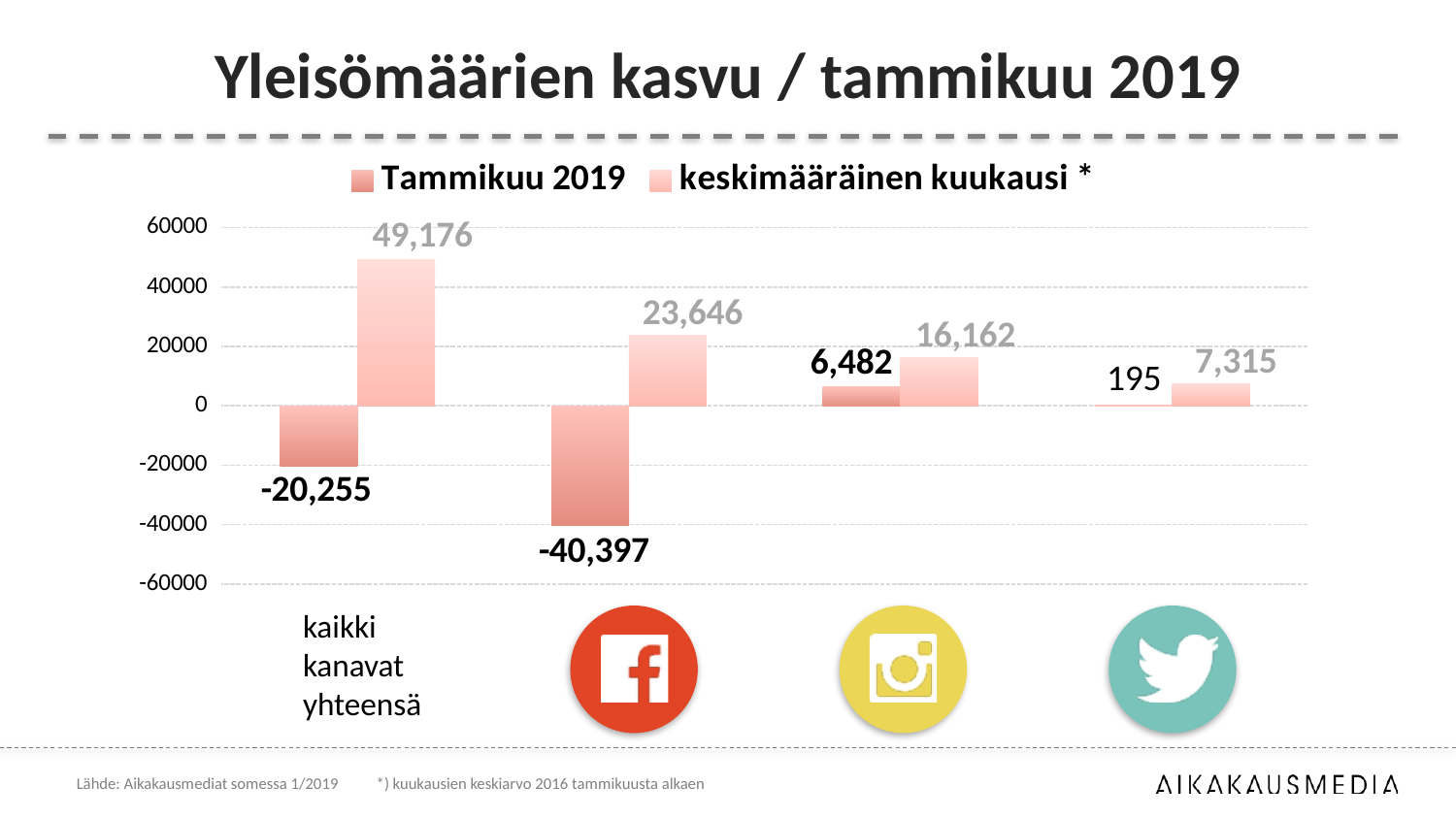
What is the keskimääräinen kuukausi value for the Instagram category? 16,162 What is the Tammikuu 2019 value for 'kaikki kanavat yhteensä'? -20,255 Which is larger for the Facebook category: the Tammikuu 2019 value or the keskimääräinen kuukausi value? keskimääräinen kuukausi What kind of chart is shown on the slide? bar chart What is the Tammikuu 2019 value for the Facebook category? -40,397 How many series does the legend list? 2 Which category has the highest keskimääräinen kuukausi value? kaikki kanavat yhteensä What is the keskimääräinen kuukausi value for 'kaikki kanavat yhteensä'? 49,176 What is the Tammikuu 2019 value for the Twitter category? 195 What is the difference between the keskimääräinen kuukausi value and the Tammikuu 2019 value for the Instagram category? 9,680 Which category has the lowest Tammikuu 2019 value? Facebook How many categories are shown on the x axis of the chart? 4